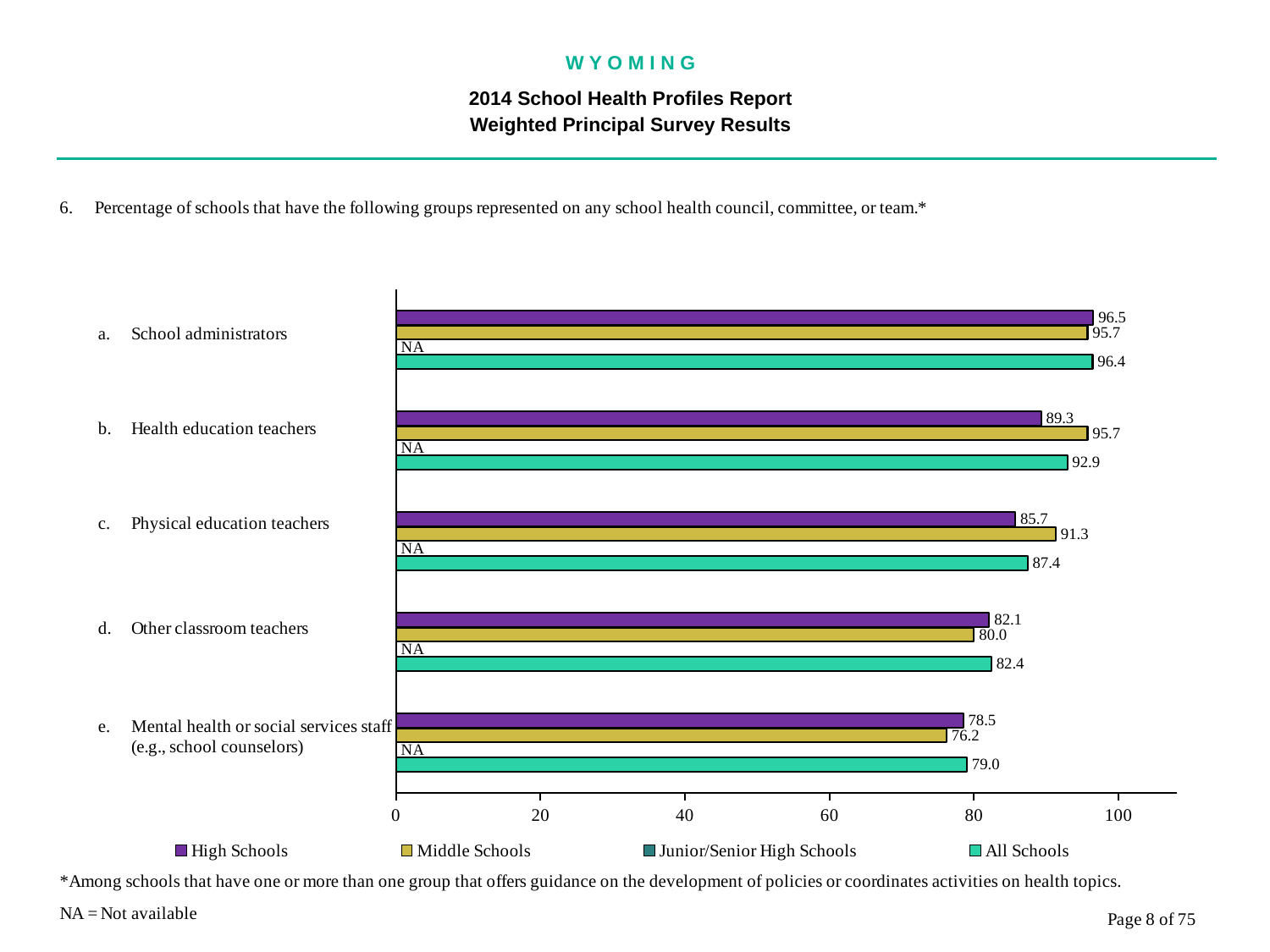
Which category has the highest value for All Schools? School administrators Is the value for All Schools for Physical education teachers greater or less than 80? greater What is the value for All Schools for Mental health or social services staff? 79.0 Which is larger for Other classroom teachers: the High Schools value or the Middle Schools value? High Schools What kind of chart is shown on the slide? bar chart How many categories are shown on the chart? 5 What is the value for Middle Schools for Physical education teachers? 91.3 Which category has the lowest value for Middle Schools? Mental health or social services staff What is the difference between the High Schools and Middle Schools values for Health education teachers? 6.4 What is the value for High Schools for School administrators? 96.5 How many series does the legend list? 4 What value is shown for Junior/Senior High Schools in each category? NA